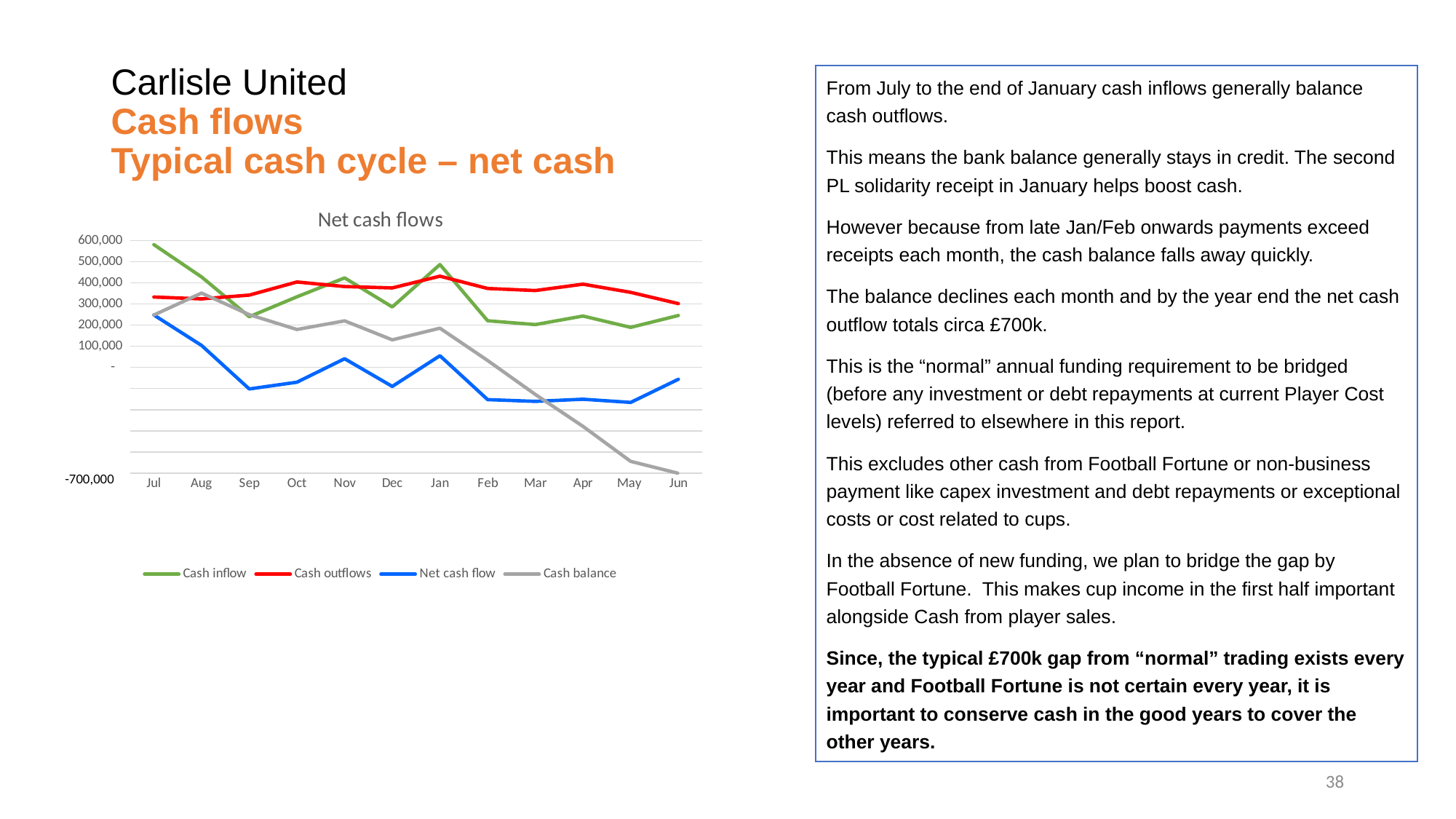
Is the value for Cash inflow in Jul greater or less than 500,000? greater Which series is drawn in grey in the chart? Cash balance In which month is Cash inflow highest? Jul What is the title of the chart? Net cash flows What kind of chart is shown on the slide? Line chart In which month is Cash balance lowest? Jun In Feb, which is larger: Cash inflow or Cash outflows? Cash outflows Is the value for Net cash flow in Sep greater or less than 0? less How many months are plotted along the x axis of the chart? 12 How many series does the chart legend list? 4 Does the Cash balance series rise or fall from Jan to Jun? Fall